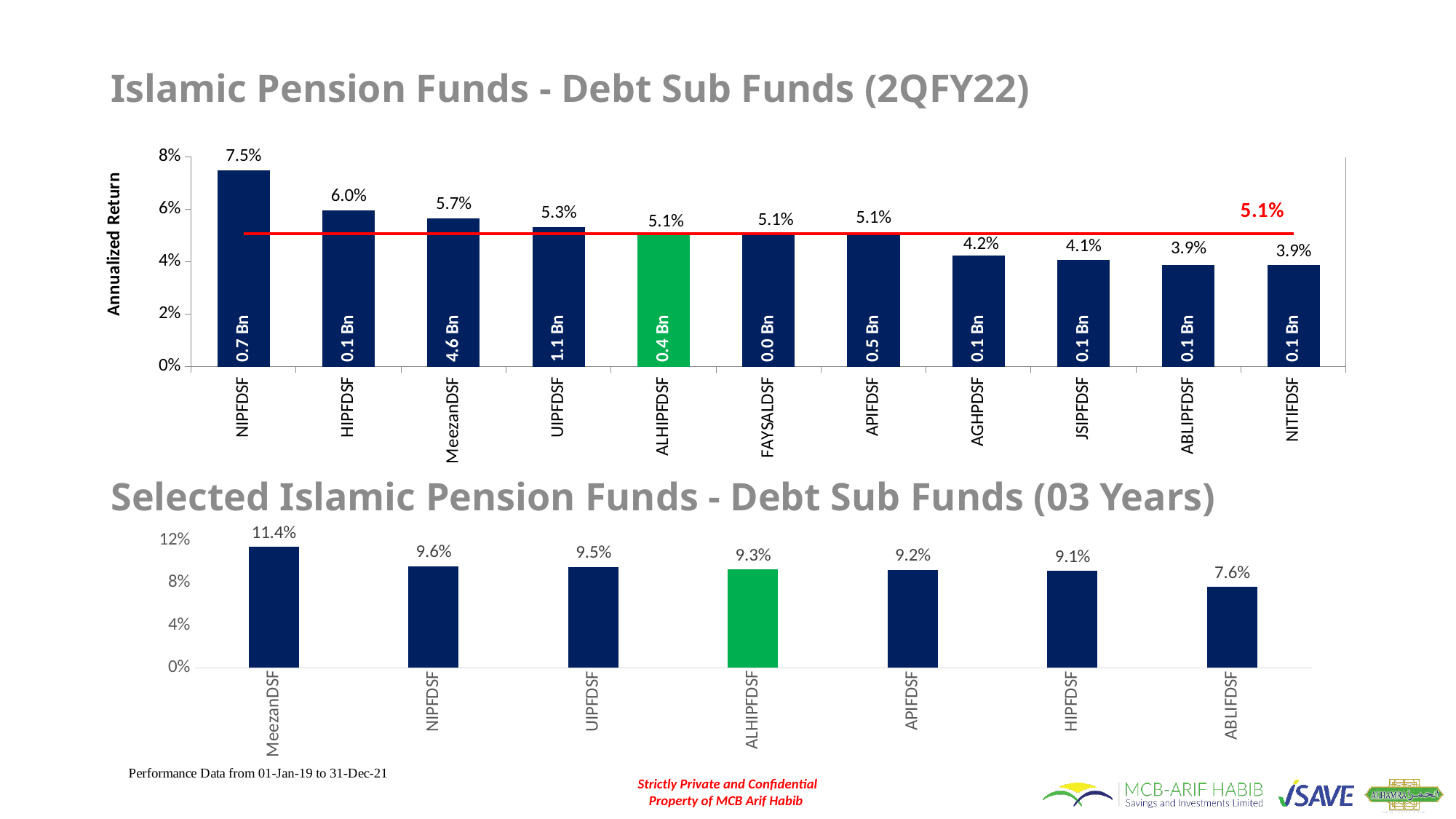
In the 'Islamic Pension Funds - Debt Sub Funds (2QFY22)' chart, what value does the red horizontal line mark? 5.1% In the 'Selected Islamic Pension Funds - Debt Sub Funds (03 Years)' chart, what is the return for MeezanDSF? 11.4% In the 'Islamic Pension Funds - Debt Sub Funds (2QFY22)' chart, what is the annualized return for NIPFDSF? 7.5% In the 'Selected Islamic Pension Funds - Debt Sub Funds (03 Years)' chart, how many funds are plotted? 7 What kind of chart is the 'Selected Islamic Pension Funds - Debt Sub Funds (03 Years)' chart? Bar chart In the 'Selected Islamic Pension Funds - Debt Sub Funds (03 Years)' chart, what is the difference between the returns of MeezanDSF and ABLIFDSF? 3.8% In the 'Islamic Pension Funds - Debt Sub Funds (2QFY22)' chart, what is the difference between the annualized returns of HIPFDSF and AGHPDSF? 1.8% In the 'Islamic Pension Funds - Debt Sub Funds (2QFY22)' chart, which fund has the highest annualized return? NIPFDSF In the 'Islamic Pension Funds - Debt Sub Funds (2QFY22)' chart, which fund's bar is coloured green? ALHIPFDSF In the 'Selected Islamic Pension Funds - Debt Sub Funds (03 Years)' chart, which fund has the lowest return? ABLIFDSF In the 'Islamic Pension Funds - Debt Sub Funds (2QFY22)' chart, how many funds are plotted? 11 In the 'Islamic Pension Funds - Debt Sub Funds (2QFY22)' chart, what is the fund size shown inside the MeezanDSF bar? 4.6 Bn